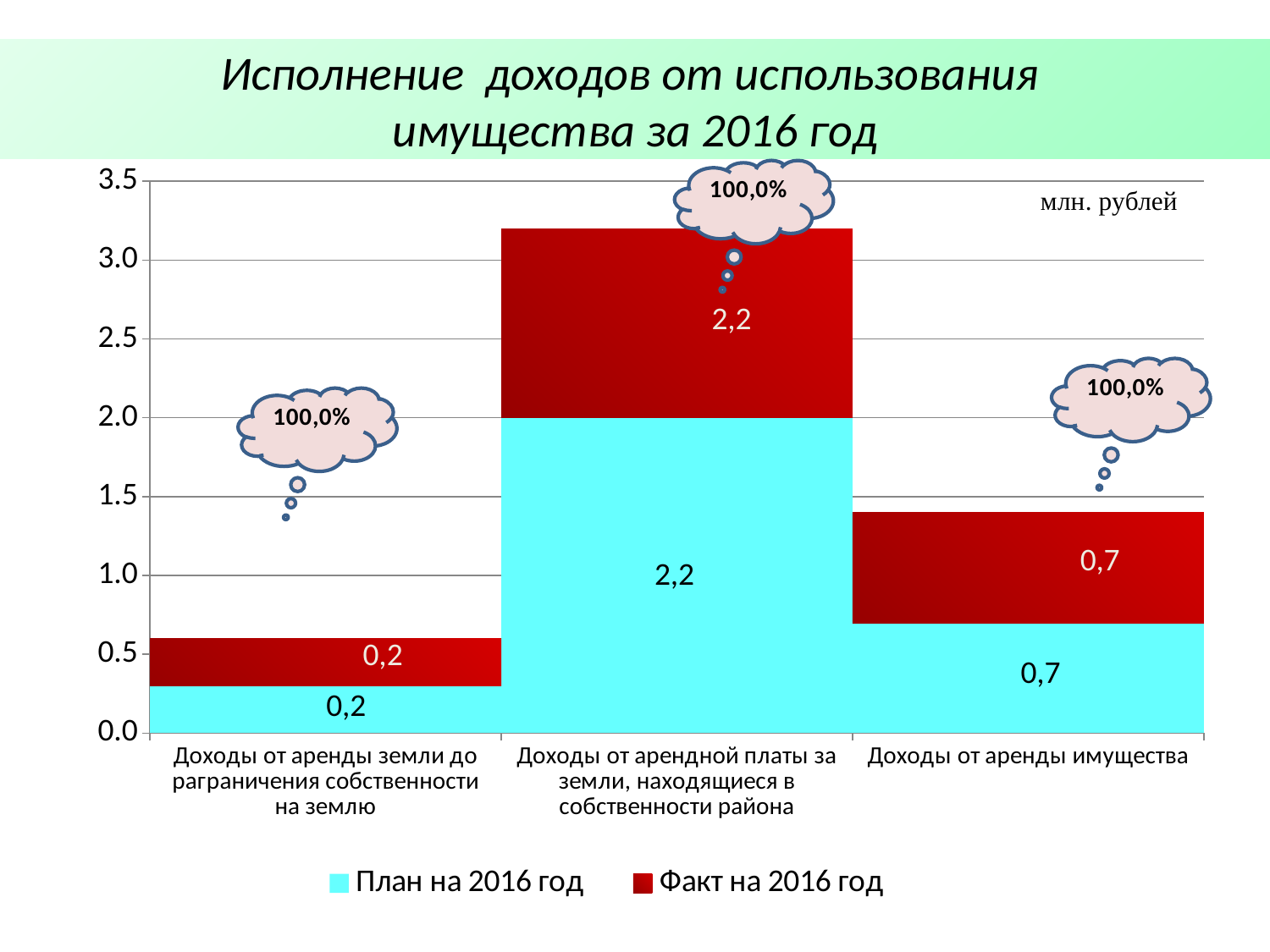
What kind of chart is shown on the slide? bar chart How many categories are shown on the x axis? 3 Which category has the lowest value for 'Факт на 2016 год'? Доходы от аренды земли до разграничения собственности на землю What is the value of 'План на 2016 год' for 'Доходы от аренды земли до разграничения собственности на землю'? 0,2 What is the difference between 'План на 2016 год' and 'Факт на 2016 год' for 'Доходы от аренды имущества'? 0 What percentage is shown in the cloud callouts above each category? 100,0% Which is larger for 'Факт на 2016 год': 'Доходы от аренды имущества' or 'Доходы от аренды земли до разграничения собственности на землю'? Доходы от аренды имущества What is the value of 'Факт на 2016 год' for 'Доходы от арендной платы за земли, находящиеся в собственности района'? 2,2 Which category has the highest value for 'План на 2016 год'? Доходы от арендной платы за земли, находящиеся в собственности района What unit is indicated in the top right corner of the chart? млн. рублей What is the value of 'План на 2016 год' for 'Доходы от аренды имущества'? 0,7 How many series does the legend list? 2